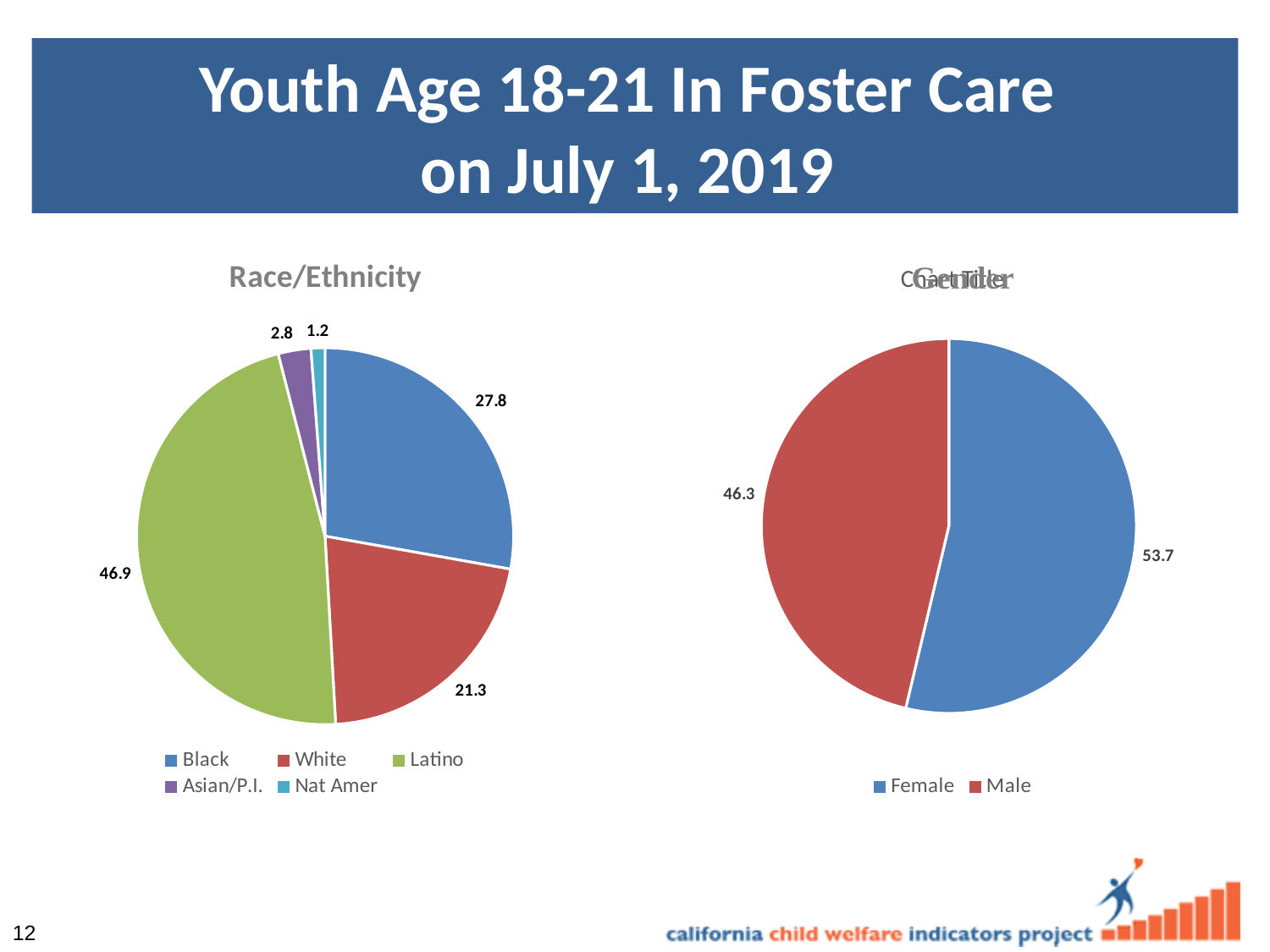
In the Gender chart, what is the value for Female? 53.7 In the Gender chart, what is the value for Male? 46.3 In the Race/Ethnicity chart, what is the difference between the Black and White values? 6.5 In the Race/Ethnicity chart, how many categories are shown? 5 In the Race/Ethnicity chart, which category has the largest slice? Latino In the Race/Ethnicity chart, what is the value for Black? 27.8 In the Race/Ethnicity chart, what is the value for Nat Amer? 1.2 In the Race/Ethnicity chart, which category has the smallest slice? Nat Amer In the Race/Ethnicity chart, what is the value for White? 21.3 What type of chart is the Gender chart? Pie chart In the Race/Ethnicity chart, what is the value for Latino? 46.9 In the Gender chart, which is larger, Female or Male? Female